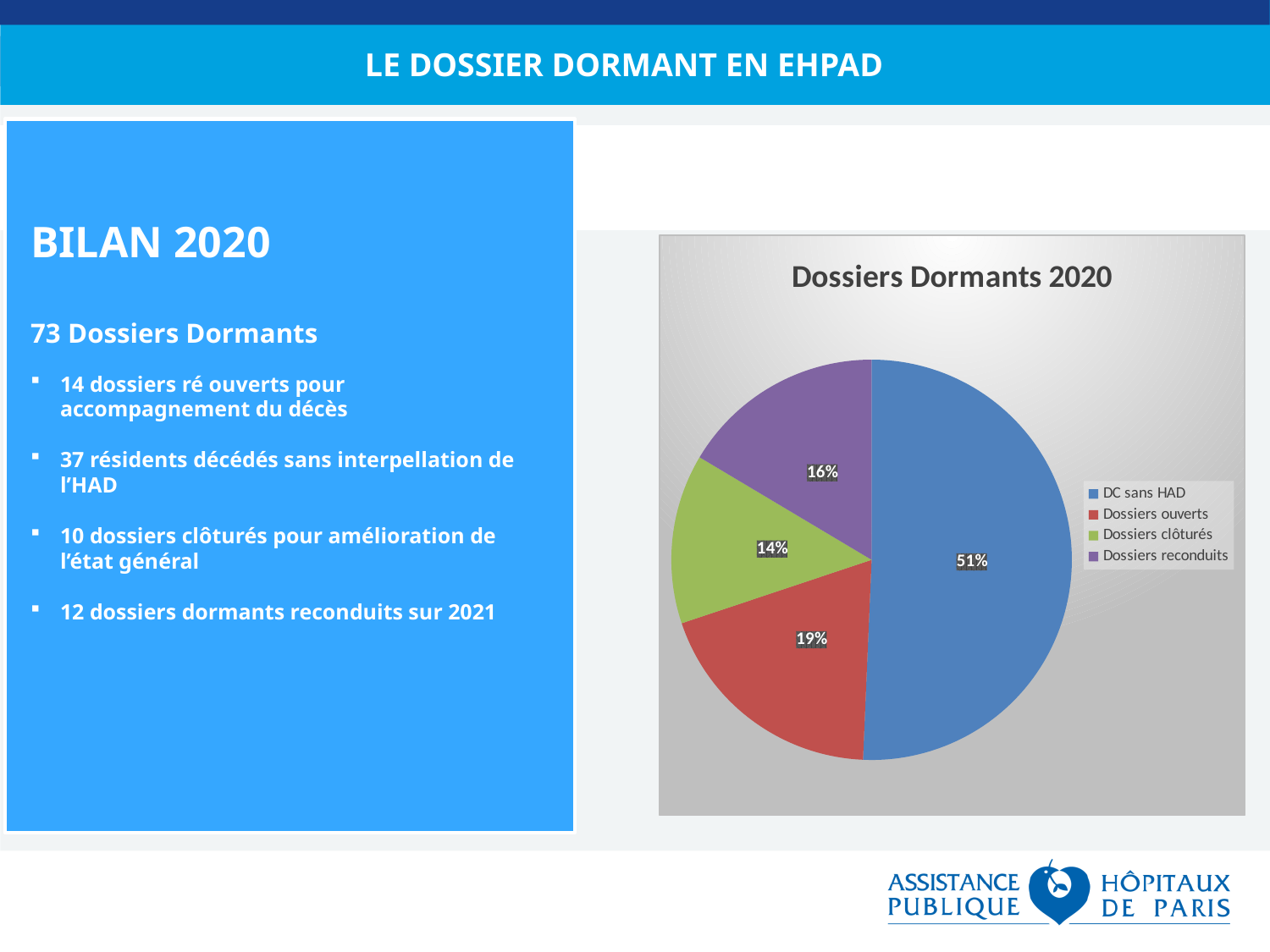
Which category has the largest share of the pie? DC sans HAD What is the difference in percentage points between DC sans HAD and Dossiers ouverts? 32 What percentage of the pie is labelled for DC sans HAD? 51% Which is larger, the share for Dossiers reconduits or the share for Dossiers clôturés? Dossiers reconduits What colour is the slice for Dossiers clôturés? Green What percentage of the pie is labelled for Dossiers ouverts? 19% What percentage of the pie is labelled for Dossiers reconduits? 16% How many categories does the legend list? 4 What is the title of the chart? Dossiers Dormants 2020 Which category has the smallest share of the pie? Dossiers clôturés What percentage of the pie is labelled for Dossiers clôturés? 14% What type of chart is shown on the slide? Pie chart